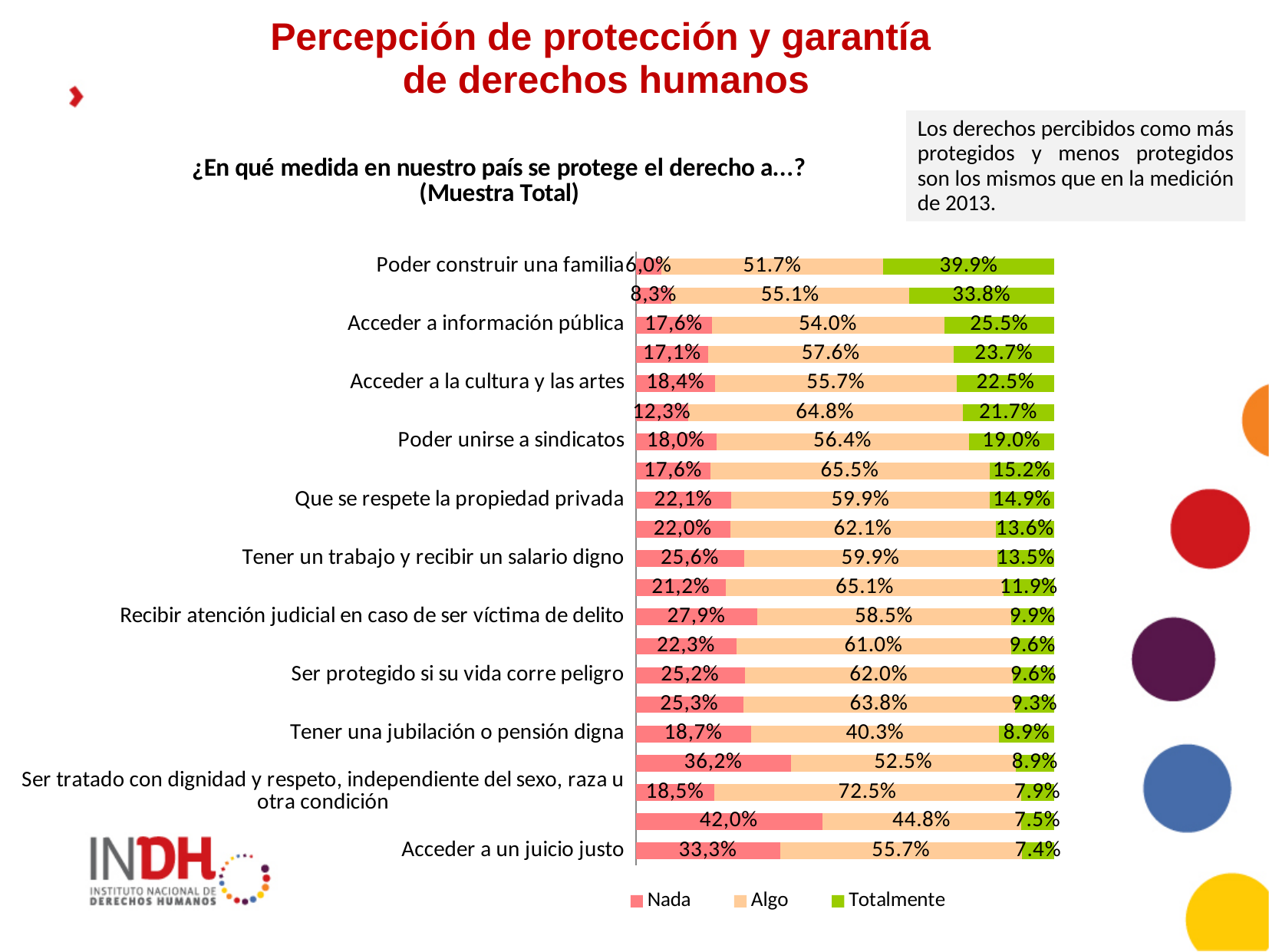
How many series does the legend list? 3 What kind of chart is shown on the slide? Stacked bar chart What is the 'Nada' value for 'Recibir atención judicial en caso de ser víctima de delito'? 27,9% What is the difference between the 'Totalmente' values for 'Poder construir una familia' and 'Acceder a un juicio justo'? 32.5 percentage points What is the 'Nada' value for 'Acceder a un juicio justo'? 33,3% What is the 'Totalmente' value for 'Poder construir una familia'? 39.9% What is the 'Totalmente' value for 'Tener una jubilación o pensión digna'? 8.9% Which colour represents the 'Totalmente' series in the legend? Green Which category has the lowest 'Nada' value? Poder construir una familia Which category has the highest 'Totalmente' value? Poder construir una familia What is the 'Algo' value for 'Ser tratado con dignidad y respeto, independiente del sexo, raza u otra condición'? 72.5% Which has a larger 'Algo' value: 'Ser tratado con dignidad y respeto, independiente del sexo, raza u otra condición' or 'Tener una jubilación o pensión digna'? Ser tratado con dignidad y respeto, independiente del sexo, raza u otra condición